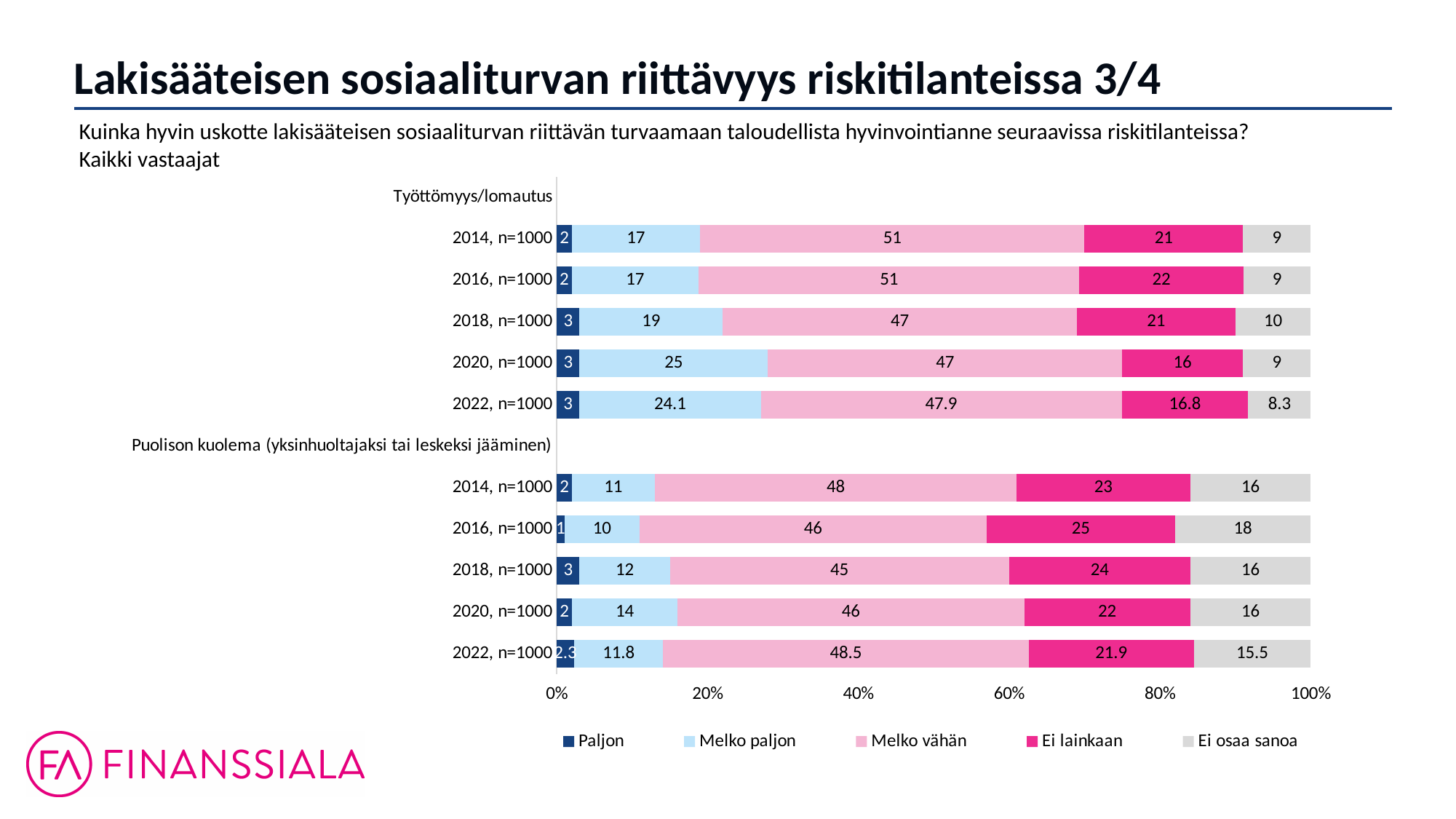
What is the 'Melko paljon' value for Työttömyys/lomautus in 2022, n=1000? 24.1 What is the difference between the 'Ei lainkaan' values for Työttömyys/lomautus in 2016 and 2020? 6 Within the Työttömyys/lomautus group, which year has the highest 'Melko paljon' value? 2020, n=1000 Which is larger: the 'Ei osaa sanoa' value for Puolison kuolema in 2016 or for Työttömyys/lomautus in 2018? Puolison kuolema in 2016 Which legend entry is shown in dark blue? Paljon How many bars are plotted in the chart? 10 Within the Puolison kuolema group, which year has the lowest 'Paljon' value? 2016, n=1000 What is the 'Melko vähän' value for Työttömyys/lomautus in 2014, n=1000? 51 What is the 'Ei osaa sanoa' value for Puolison kuolema in 2022, n=1000? 15.5 What kind of chart is shown on the slide? Stacked bar chart What is the 'Ei lainkaan' value for Puolison kuolema in 2016, n=1000? 25 How many series does the legend list? 5